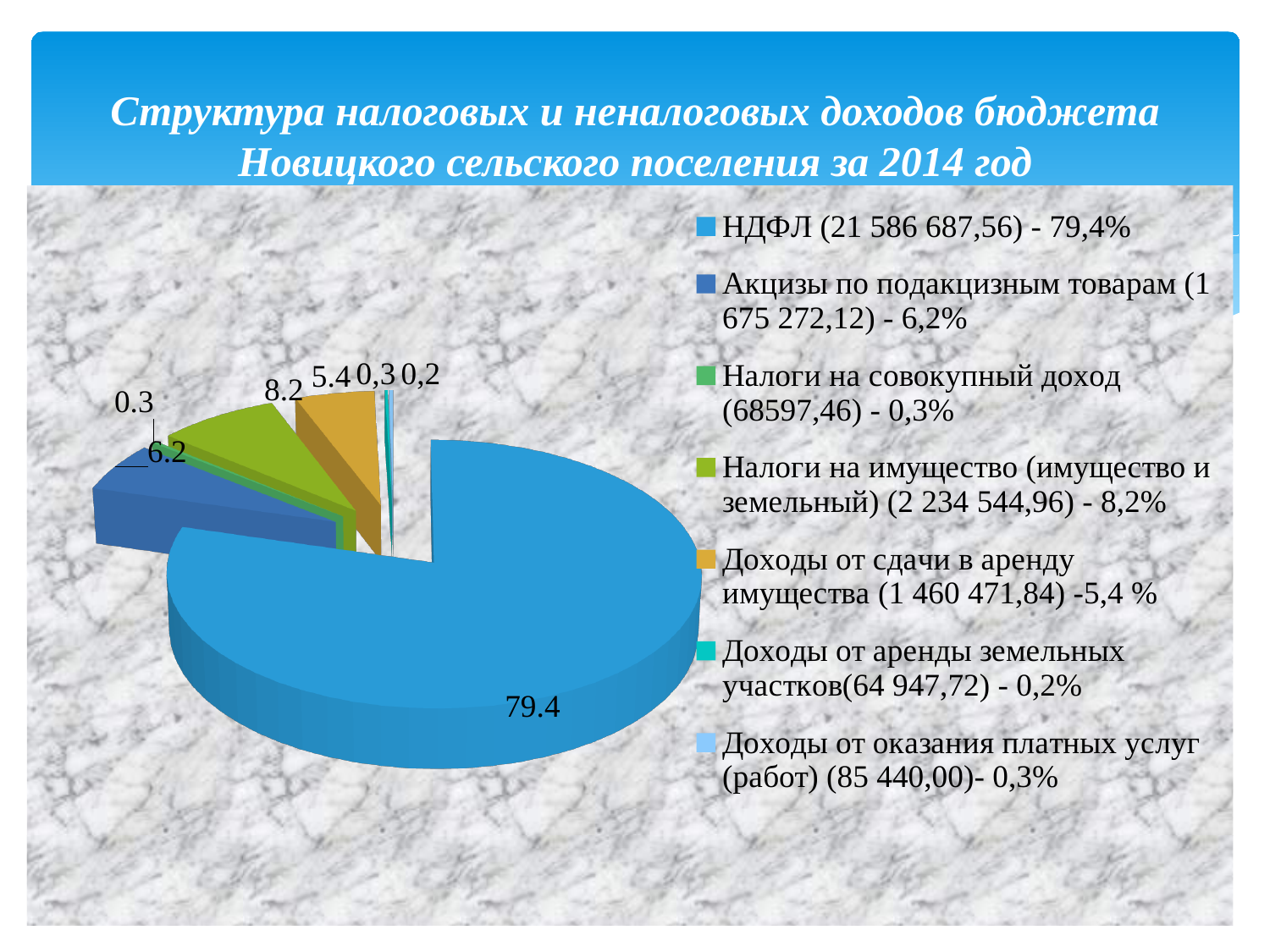
What kind of chart is shown on the slide? Pie chart Which category has the smallest slice of the pie chart? Доходы от аренды земельных участков According to the legend, what is the amount for Доходы от сдачи в аренду имущества? 1 460 471,84 According to the legend, what is the amount for Налоги на имущество (имущество и земельный)? 2 234 544,96 Which category has the largest slice of the pie chart? НДФЛ According to the legend, what percentage share does Акцизы по подакцизным товарам have? 6,2% What data label is shown on the НДФЛ slice of the pie chart? 79.4 How many categories does the legend of the pie chart list? 7 What is the difference in percentage points between the НДФЛ slice (79.4) and the Налоги на имущество slice (8.2)? 71.2 What colour is the НДФЛ slice in the pie chart? Light blue Which slice is larger: Налоги на имущество or Акцизы по подакцизным товарам? Налоги на имущество What is the difference in percentage points between the Налоги на имущество slice (8.2) and the Акцизы slice (6.2)? 2